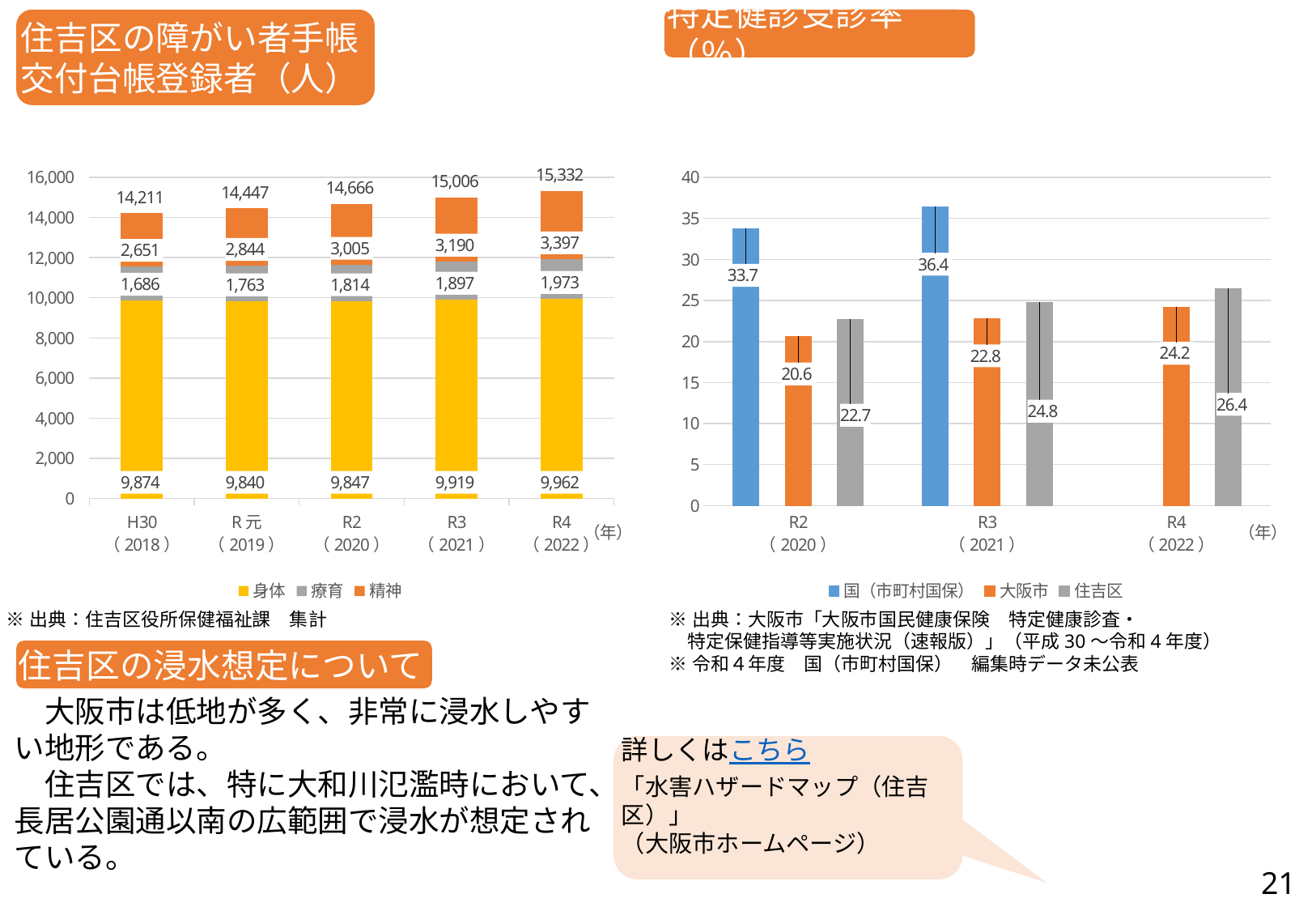
In the left chart (住吉区の障がい者手帳交付台帳登録者), what is the value of 療育 for R2 (2020)? 1,814 In the right chart (特定健診受診率), which is larger in R4 (2022): 大阪市 or 住吉区? 住吉区 In the left chart (住吉区の障がい者手帳交付台帳登録者), what is the total number of registrants for R4 (2022)? 15,332 In the left chart (住吉区の障がい者手帳交付台帳登録者), what is the value of 精神 for R3 (2021)? 3,190 In the left chart (住吉区の障がい者手帳交付台帳登録者), how many series does the legend list? 3 In the left chart (住吉区の障がい者手帳交付台帳登録者), what is the difference between the 精神 values for R4 (2022) and H30 (2018)? 746 In the right chart (特定健診受診率), which series has the highest value in R3 (2021)? 国（市町村国保） In the left chart (住吉区の障がい者手帳交付台帳登録者), what is the value of 身体 for H30 (2018)? 9,874 In the right chart (特定健診受診率), what is the value for 住吉区 in R3 (2021)? 24.8 In the left chart (住吉区の障がい者手帳交付台帳登録者), do the total values rise or fall from H30 to R4? rise In the right chart (特定健診受診率), what is the value for 国（市町村国保） in R2 (2020)? 33.7 What kind of chart is the right chart (特定健診受診率)? bar chart